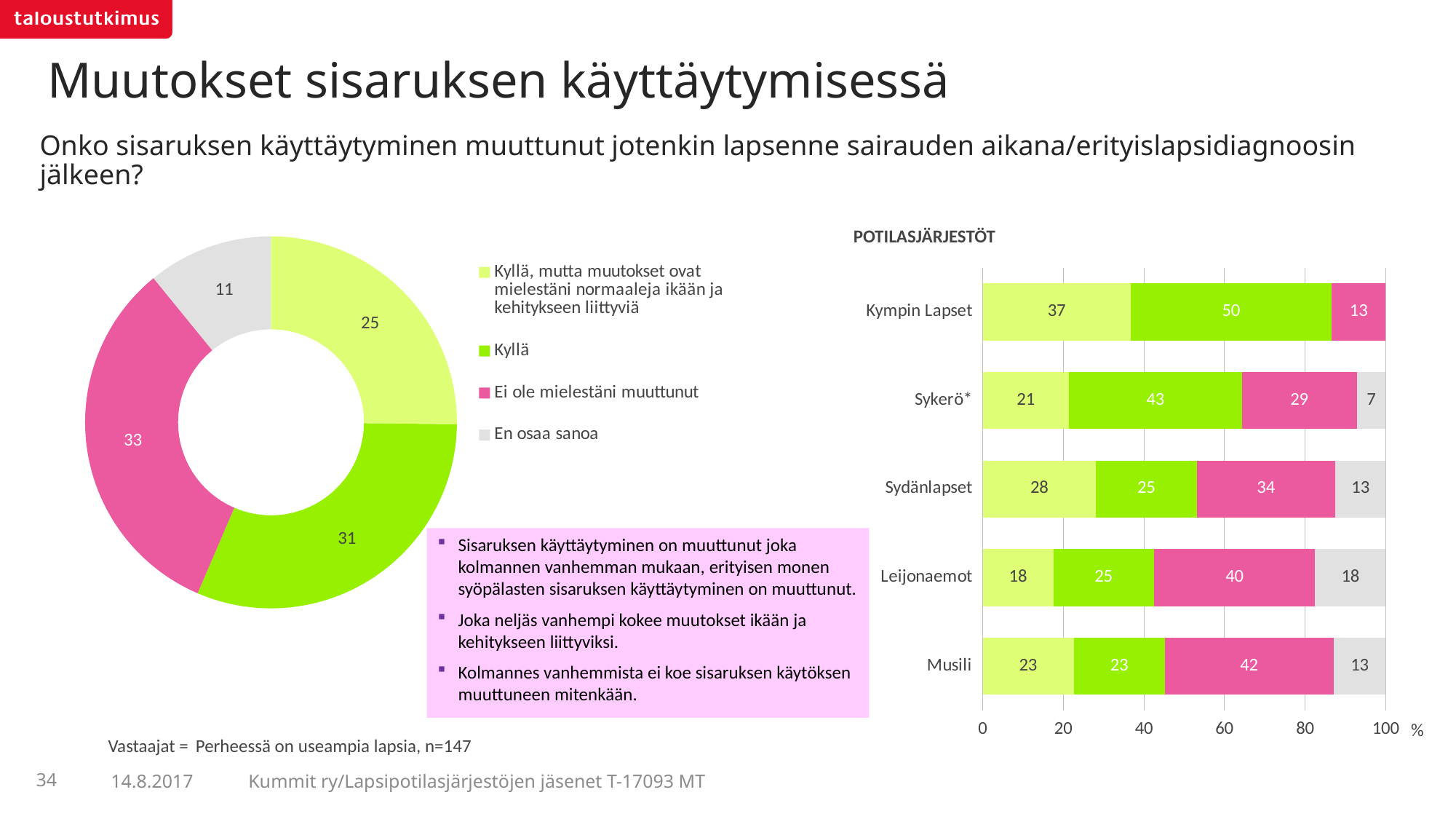
In the POTILASJÄRJESTÖT chart, what is the difference between the 'En osaa sanoa' values for Leijonaemot and Sykerö*? 11 In the POTILASJÄRJESTÖT chart, what is the 'Kyllä' value for Kympin Lapset? 50 What kind of chart is the chart on the left of the slide? Donut chart What kind of chart is the POTILASJÄRJESTÖT chart on the right? Stacked bar chart In the POTILASJÄRJESTÖT chart, how many organisations are shown? 5 In the POTILASJÄRJESTÖT chart, which organisation has the highest 'Kyllä' value? Kympin Lapset In the POTILASJÄRJESTÖT chart, what is the 'Ei ole mielestäni muuttunut' value for Musili? 42 In the donut chart on the left, which category has the lowest value? En osaa sanoa In the donut chart on the left, what is the value for 'Ei ole mielestäni muuttunut'? 33 How many entries does the legend of the donut chart on the left list? 4 In the donut chart on the left, what is the difference between the 'Kyllä' value and the 'En osaa sanoa' value? 20 In the POTILASJÄRJESTÖT chart, is the 'Ei ole mielestäni muuttunut' value for Leijonaemot larger or smaller than that for Sykerö*? Larger